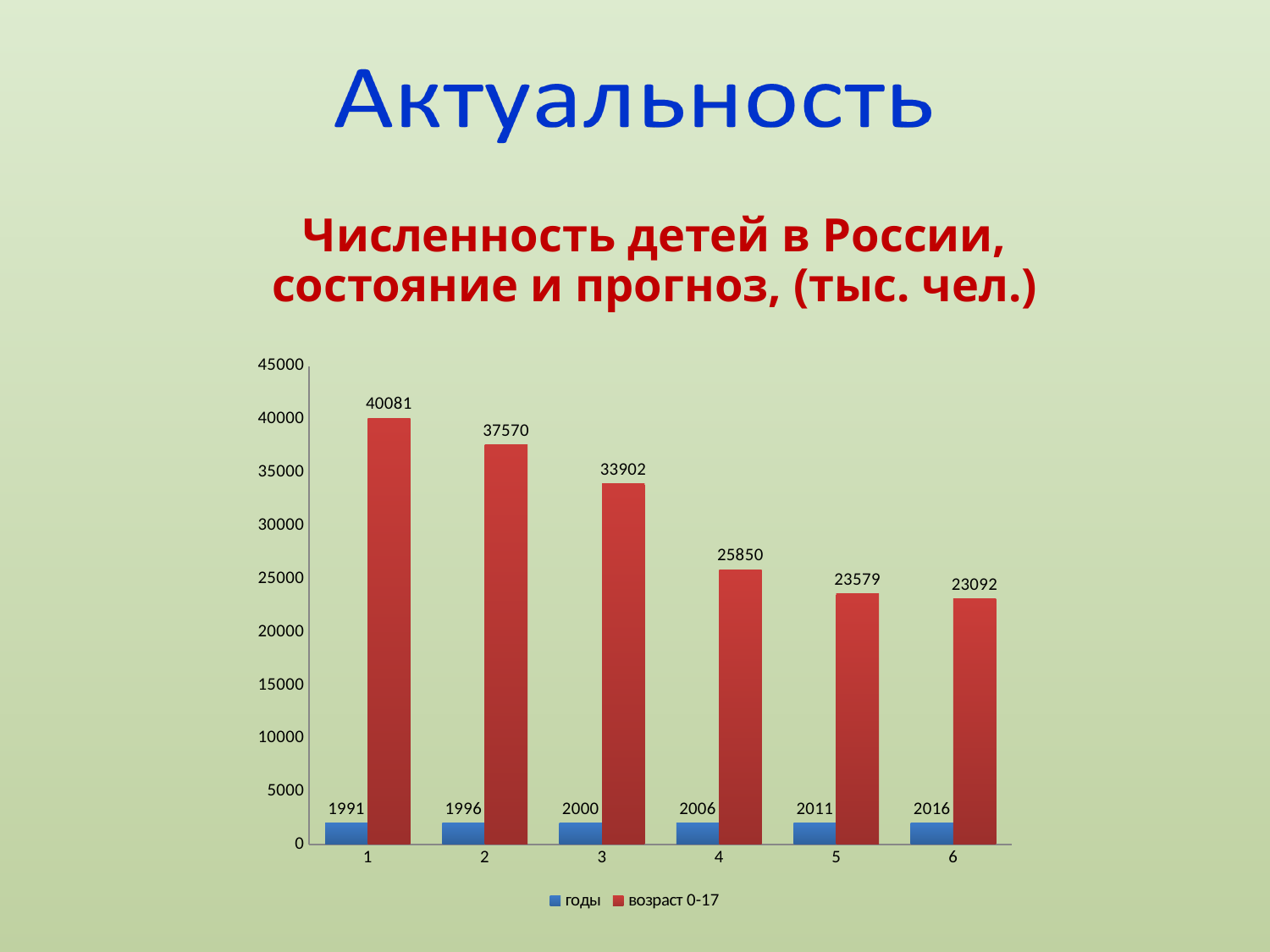
Which is larger, the 'возраст 0-17' value for 2011 or for 2016? 2011 Which year has the lowest value in the 'возраст 0-17' series? 2016 What is the difference between the 'возраст 0-17' values for 2000 and 2006? 8052 What is the value of the 'возраст 0-17' series for the year 2006? 25850 Which year has the highest value in the 'возраст 0-17' series? 1991 What kind of chart is shown on the slide? bar chart What is the value of the 'возраст 0-17' series for the year 2016? 23092 How many categories are shown on the x axis of the chart? 6 How many series does the chart legend list? 2 What is the value of the 'возраст 0-17' series for the year 1991? 40081 What is the difference between the 'возраст 0-17' values for 1991 and 2016? 16989 Do the values of the 'возраст 0-17' series rise or fall from category 1 to category 6? fall